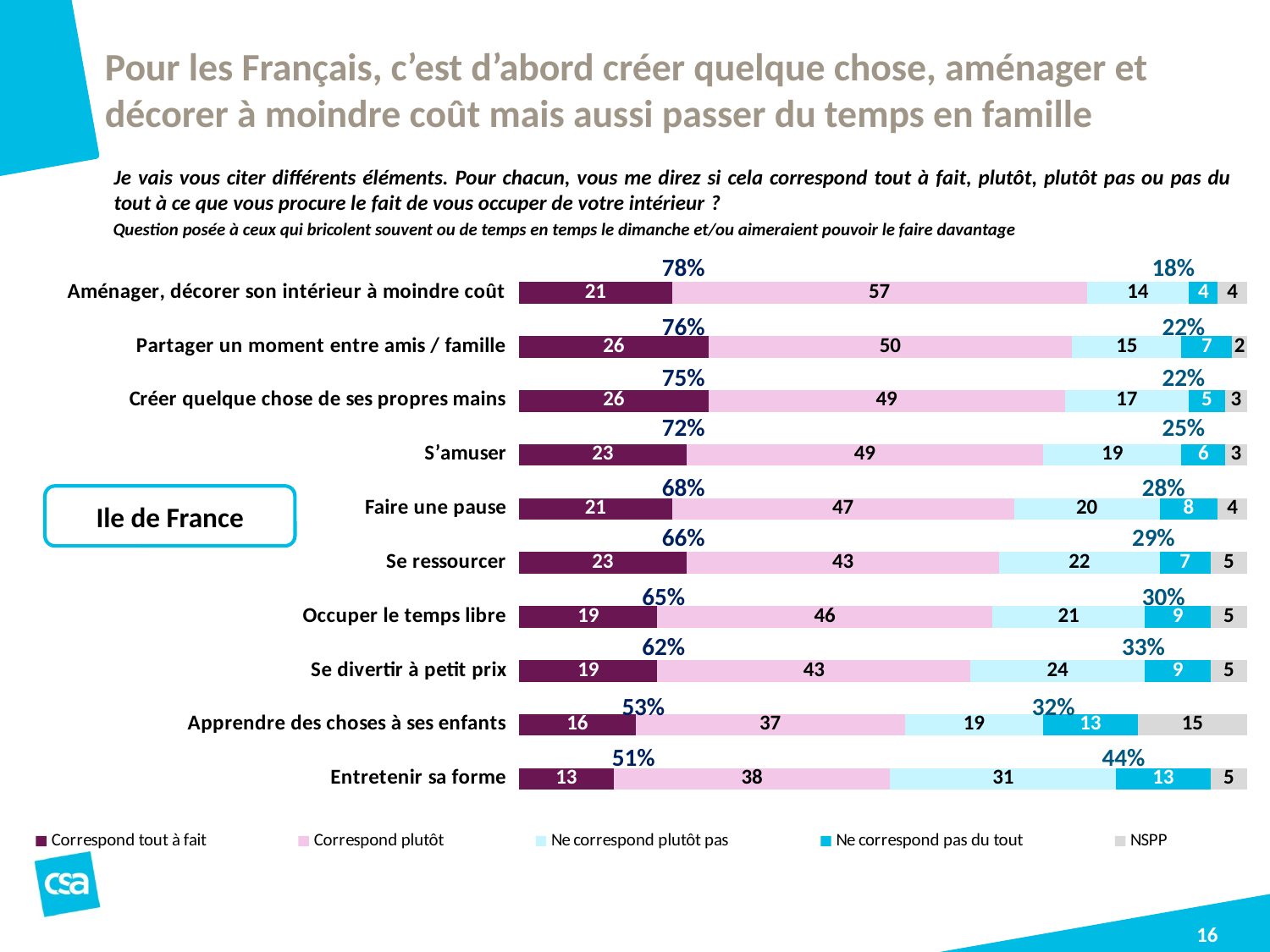
What is the difference between the 'Correspond plutôt' values for 'Aménager, décorer son intérieur à moindre coût' and 'Entretenir sa forme'? 19 How many series does the legend list? 5 What kind of chart is shown on the slide? Stacked bar chart Which has the larger 'Ne correspond plutôt pas' value: 'Se divertir à petit prix' or 'Se ressourcer'? Se divertir à petit prix What text appears in the box to the left of the chart? Ile de France What is the value of 'Ne correspond pas du tout' for 'Apprendre des choses à ses enfants'? 13 Which category has the lowest 'Correspond tout à fait' value? Entretenir sa forme What is the value of 'Ne correspond plutôt pas' for 'Entretenir sa forme'? 31 What is the value of 'Correspond plutôt' for 'Aménager, décorer son intérieur à moindre coût'? 57 How many categories (items) are plotted in the chart? 10 What combined percentage is shown above the left side of the bar for 'Faire une pause'? 68% Which category has the highest 'NSPP' value? Apprendre des choses à ses enfants